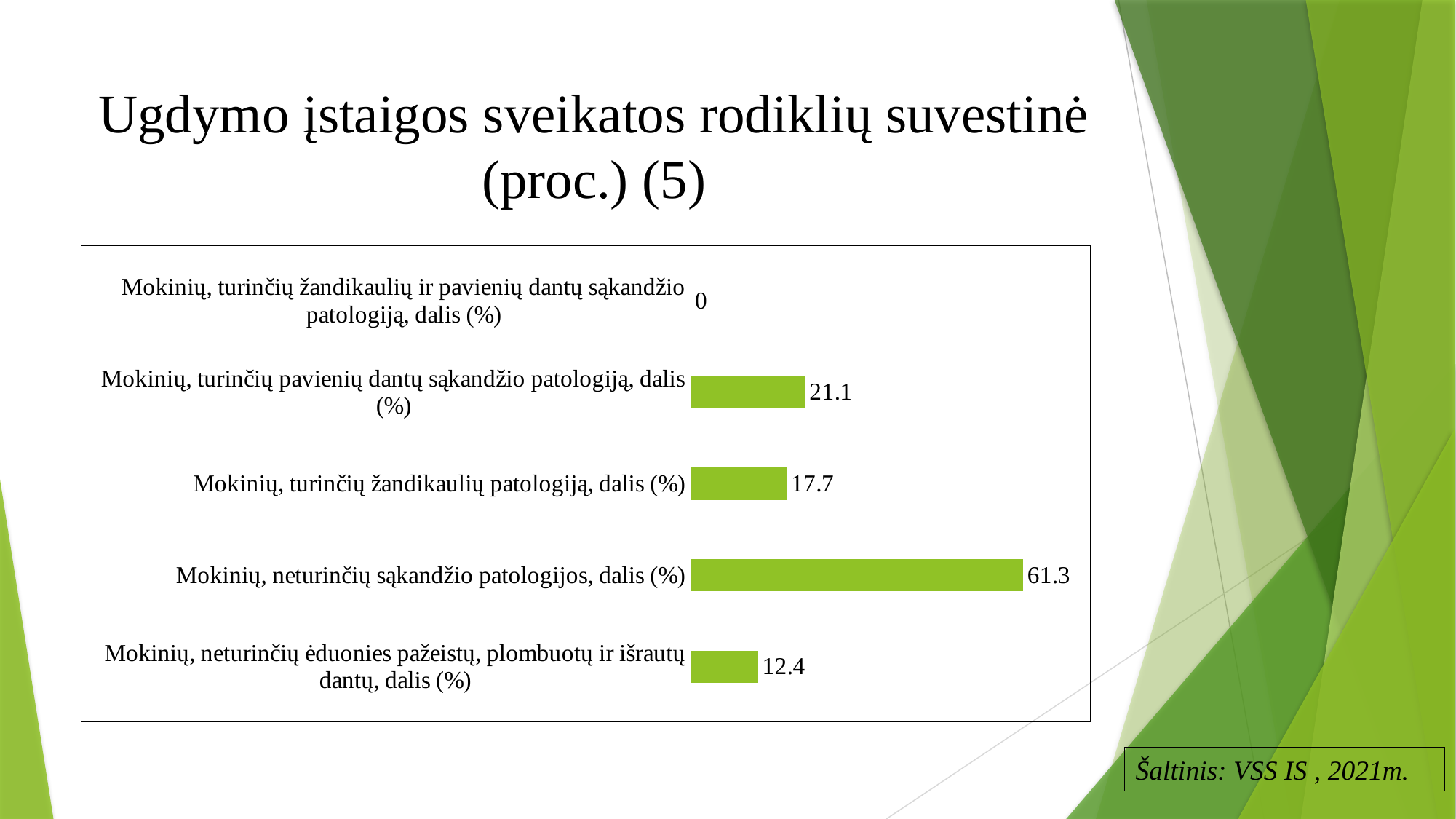
What is the title of the slide? Ugdymo įstaigos sveikatos rodiklių suvestinė (proc.) (5) How many categories are shown in the chart? 5 What is the value for "Mokinių, neturinčių ėduonies pažeistų, plombuotų ir išrautų dantų, dalis (%)"? 12.4 What is the value for "Mokinių, neturinčių sąkandžio patologijos, dalis (%)"? 61.3 What is the difference between the values for "Mokinių, turinčių pavienių dantų sąkandžio patologiją, dalis (%)" and "Mokinių, turinčių žandikaulių patologiją, dalis (%)"? 3.4 Which category has the lowest value? Mokinių, turinčių žandikaulių ir pavienių dantų sąkandžio patologiją, dalis (%) What kind of chart is shown on the slide? Bar chart What is the value for "Mokinių, turinčių pavienių dantų sąkandžio patologiją, dalis (%)"? 21.1 Which is larger: the value for "Mokinių, turinčių žandikaulių patologiją, dalis (%)" or for "Mokinių, neturinčių ėduonies pažeistų, plombuotų ir išrautų dantų, dalis (%)"? Mokinių, turinčių žandikaulių patologiją, dalis (%) What is the value for "Mokinių, turinčių žandikaulių patologiją, dalis (%)"? 17.7 Which category has the highest value? Mokinių, neturinčių sąkandžio patologijos, dalis (%) What is the value for "Mokinių, turinčių žandikaulių ir pavienių dantų sąkandžio patologiją, dalis (%)"? 0